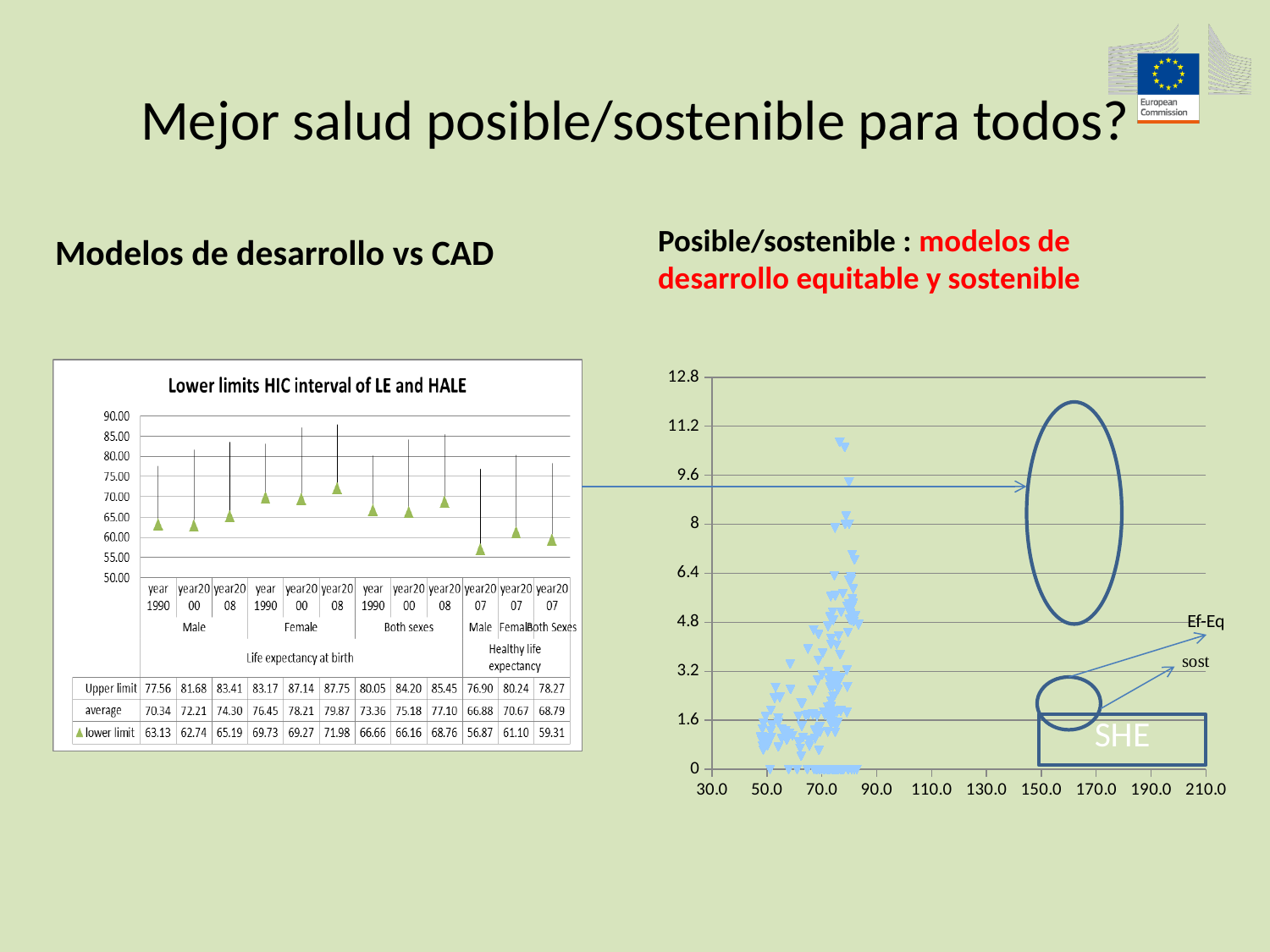
In the chart titled 'Lower limits HIC interval of LE and HALE', how many categories are shown along the x axis? 12 In the chart titled 'Lower limits HIC interval of LE and HALE', what is the upper limit for Female, year2008? 87.75 In the chart titled 'Lower limits HIC interval of LE and HALE', what is the lower limit for Male, year 1990? 63.13 In the chart titled 'Lower limits HIC interval of LE and HALE', which category has the lowest lower limit? Healthy life expectancy, Male, year 07 In the chart titled 'Lower limits HIC interval of LE and HALE', what is the difference between the upper limit and the lower limit for Male, year 1990? 14.43 In the chart titled 'Lower limits HIC interval of LE and HALE', which has the larger lower limit: Male year2008 or Female year2008? Female year2008 In the chart titled 'Lower limits HIC interval of LE and HALE', do the lower limits for Female rise or fall from year 1990 to year2008? rise What kind of chart is the chart on the right side of the slide? scatter chart In the chart titled 'Lower limits HIC interval of LE and HALE', what is the average for Both sexes, year2000? 75.18 In the chart titled 'Lower limits HIC interval of LE and HALE', what is the lower limit for Healthy life expectancy, Male, year 07? 56.87 In the chart titled 'Lower limits HIC interval of LE and HALE', which category has the highest upper limit? Female, year2008 What is the highest value shown on the x axis of the chart on the right side of the slide? 210.0